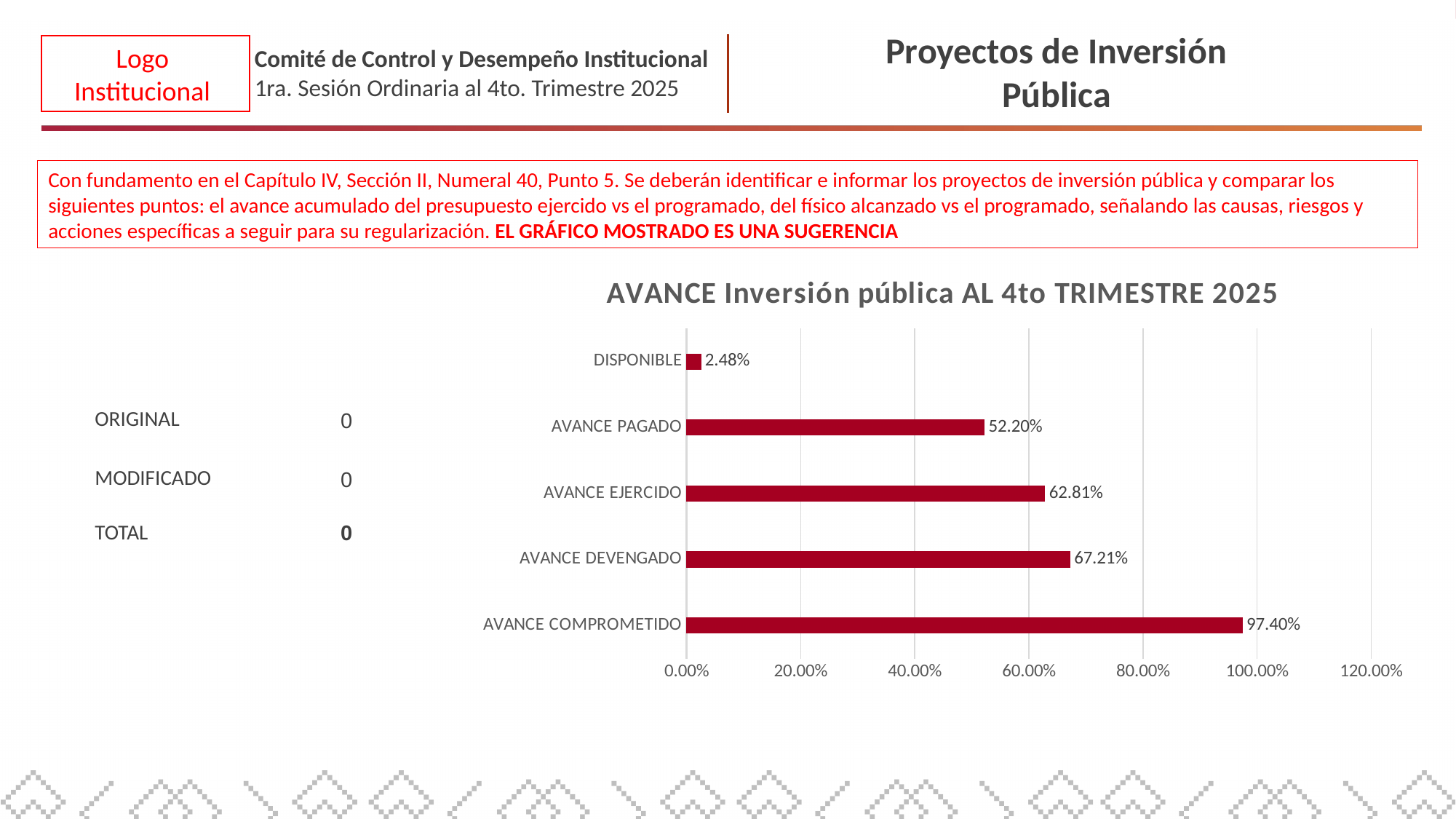
What is the difference between AVANCE COMPROMETIDO and AVANCE PAGADO? 45.20% What is the value for AVANCE COMPROMETIDO? 97.40% Which category has the lowest value? DISPONIBLE What is the title of the chart? AVANCE Inversión pública AL 4to TRIMESTRE 2025 Which is larger, AVANCE DEVENGADO or AVANCE EJERCIDO? AVANCE DEVENGADO What is the value for DISPONIBLE? 2.48% Which category has the highest value? AVANCE COMPROMETIDO What is the value for AVANCE PAGADO? 52.20% What kind of chart is shown? Bar chart How many categories are shown in the chart? 5 What is the value for AVANCE EJERCIDO? 62.81% What is the value for AVANCE DEVENGADO? 67.21%